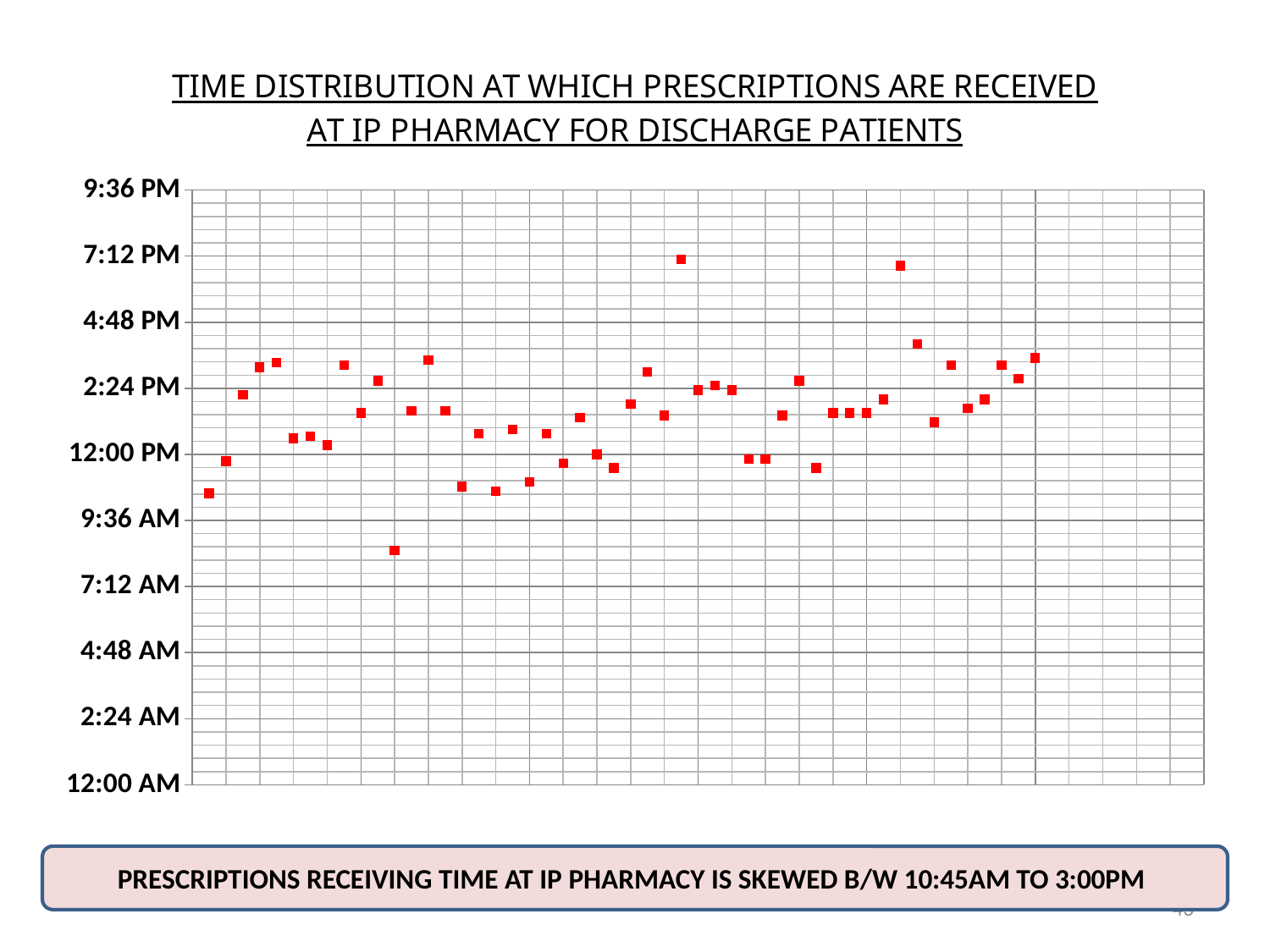
How many points on the chart fall below the 9:36 AM gridline? 1 According to the text box below the chart, between which times is the prescription receiving time skewed? 10:45AM to 3:00PM What kind of chart is shown on the slide? Scatter chart What is the highest time label shown on the vertical axis? 9:36 PM What is the lowest time label shown on the vertical axis? 12:00 AM Is the latest (highest) point on the chart before or after 4:48 PM? after How many time labels are shown on the vertical axis? 10 How many points on the chart fall above the 4:48 PM gridline? 2 What is the title of the chart? TIME DISTRIBUTION AT WHICH PRESCRIPTIONS ARE RECEIVED AT IP PHARMACY FOR DISCHARGE PATIENTS Are there any points on the chart earlier than 7:12 AM? No Is the earliest (lowest) point on the chart before or after 9:36 AM? before